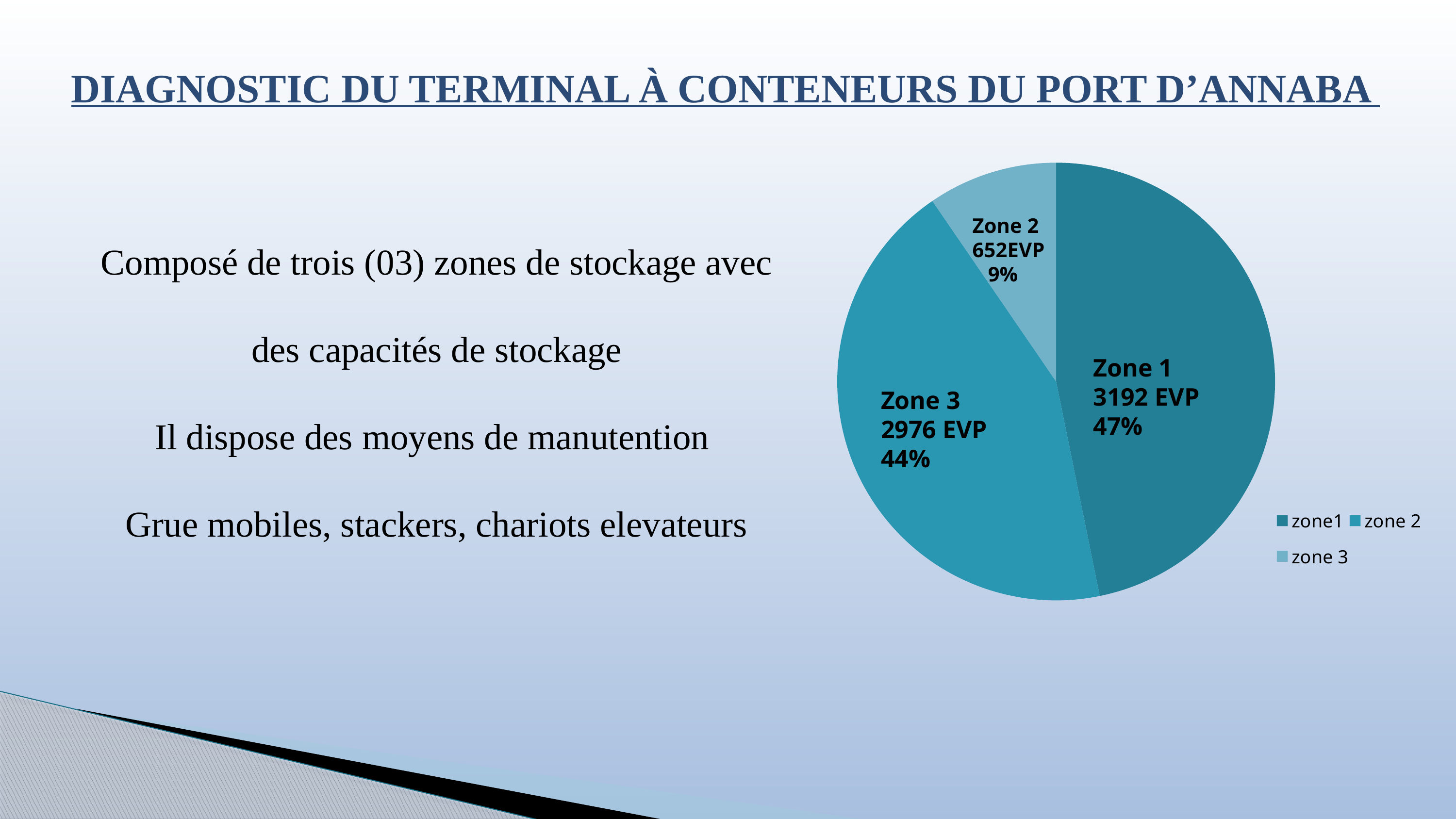
Which zone has the smallest slice? Zone 2 How many entries does the legend list? 3 What is the value for Zone 2? 652EVP What is the difference in EVP between Zone 1 and Zone 3? 216 EVP What is the value for Zone 3? 2976 EVP What kind of chart is shown on the slide? pie chart Which zone has the largest slice? Zone 1 How many slices does the pie chart have? 3 What share of the pie does Zone 2 represent? 9% What is the value for Zone 1? 3192 EVP What share of the pie does Zone 1 represent? 47% What share of the pie does Zone 3 represent? 44%